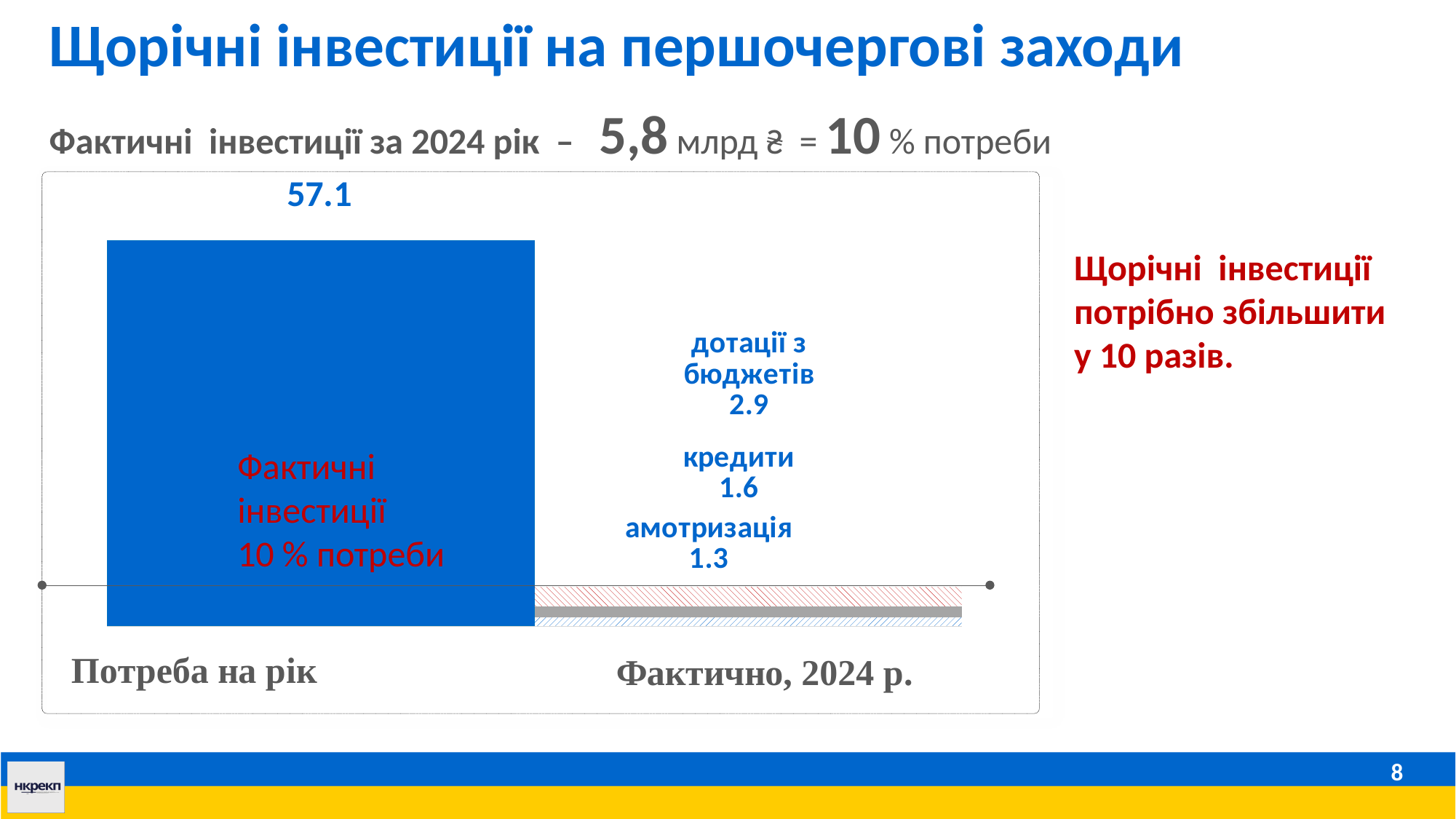
What is the value shown for "Потреба на рік"? 57.1 What is the value of the "амортизація" component for "Фактично, 2024 р."? 1.3 Which category has the higher value, "Потреба на рік" or "Фактично, 2024 р."? Потреба на рік What kind of chart is shown on the slide? bar chart What is the value of the "кредити" component for "Фактично, 2024 р."? 1.6 What is the value of the "дотації з бюджетів" component for "Фактично, 2024 р."? 2.9 Which of the three components of "Фактично, 2024 р." is the largest? дотації з бюджетів How many categories are shown on the x axis of the chart? 2 What is the title of the slide containing the chart? Щорічні інвестиції на першочергові заходи Which of the three components of "Фактично, 2024 р." is the smallest? амортизація What is the difference between "дотації з бюджетів" (2.9) and "амортизація" (1.3)? 1.6 What is the total of the stacked bar for "Фактично, 2024 р."? 5.8